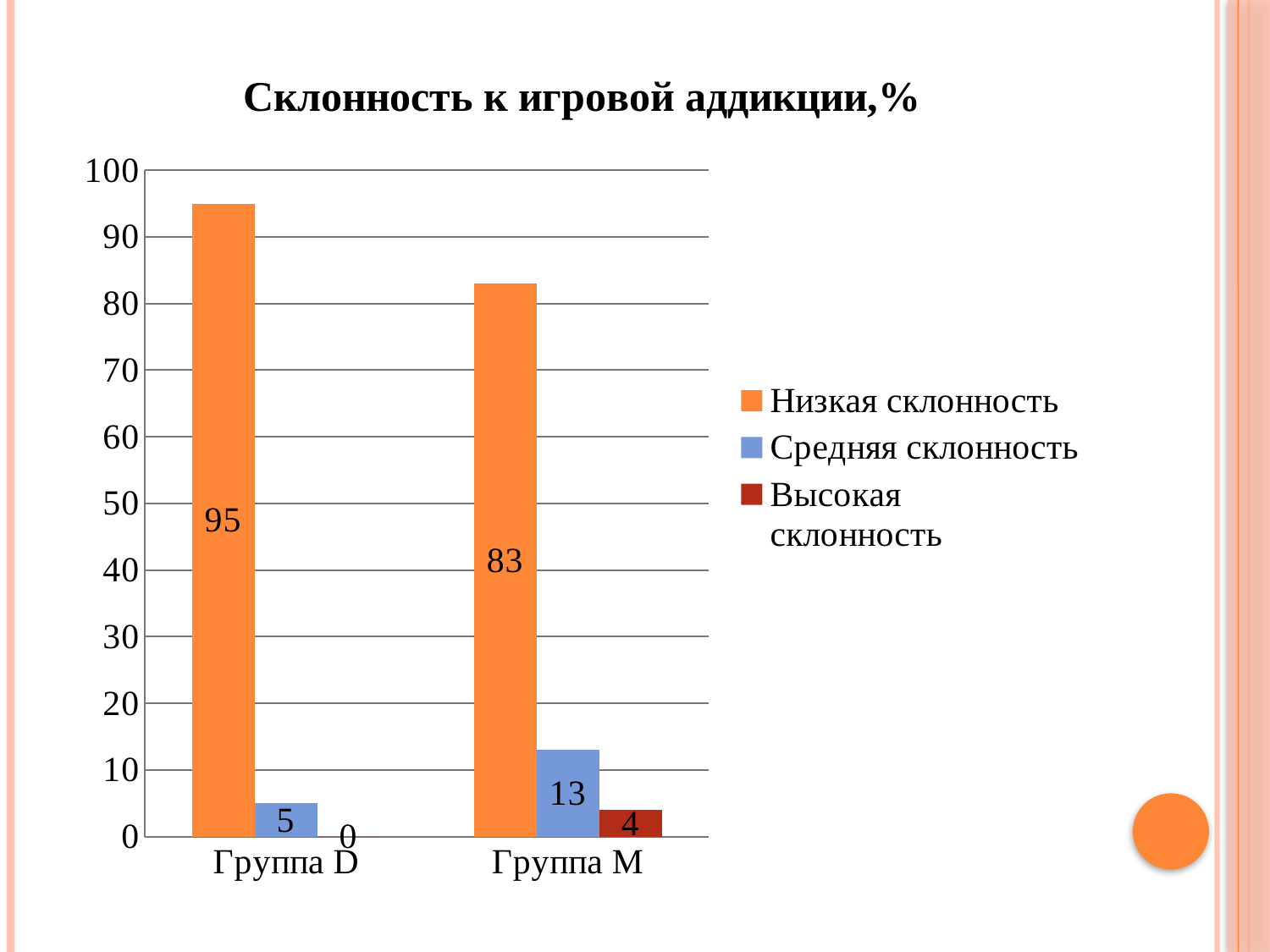
What is the value for Высокая склонность in Группа D? 0 What is the value for Средняя склонность in Группа М? 13 Which is larger: Средняя склонность in Группа D or Средняя склонность in Группа М? Группа М Which series has the lowest value in Группа М? Высокая склонность What is the title of the chart? Склонность к игровой аддикции,% What is the value for Низкая склонность in Группа D? 95 Which group has the highest value for Низкая склонность? Группа D What kind of chart is shown on the slide? Bar chart What is the difference between the Низкая склонность values for Группа D and Группа М? 12 How many series does the legend list? 3 How many groups are shown on the x axis? 2 What is the value for Высокая склонность in Группа М? 4